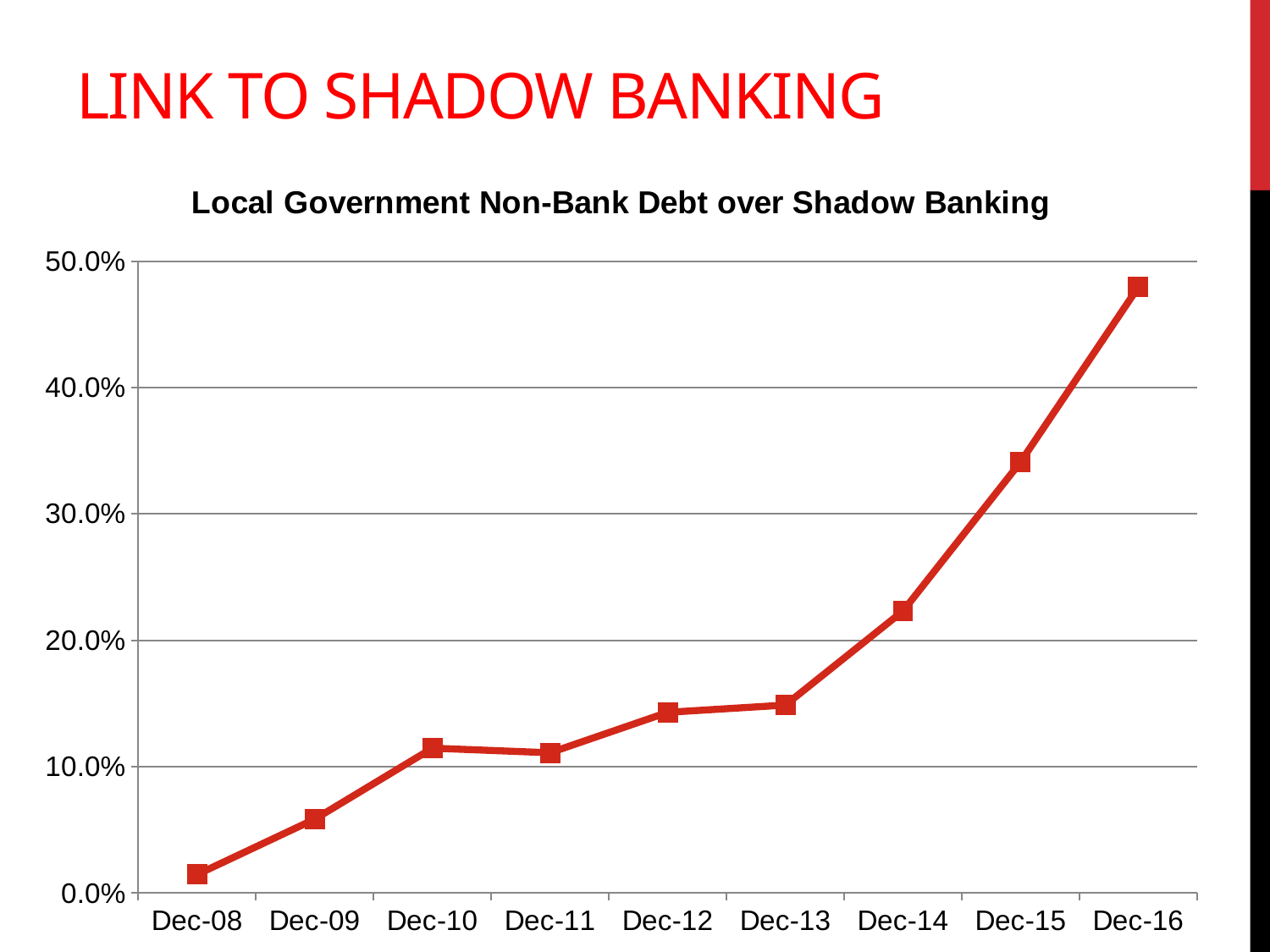
Is the value for Dec-15 greater or less than 30.0%? greater Do the values generally rise or fall from Dec-08 to Dec-16? Rise What kind of chart is shown on the slide? Line chart Is the value for Dec-16 greater or less than 40.0%? greater How many data points are plotted on the chart? 9 Which is larger, the value for Dec-14 or the value for Dec-15? Dec-15 What is the title of the chart? Local Government Non-Bank Debt over Shadow Banking Which is larger, the value for Dec-09 or the value for Dec-12? Dec-12 Which date has the lowest value on the chart? Dec-08 Is the value for Dec-08 greater or less than 10.0%? less Which date has the highest value on the chart? Dec-16